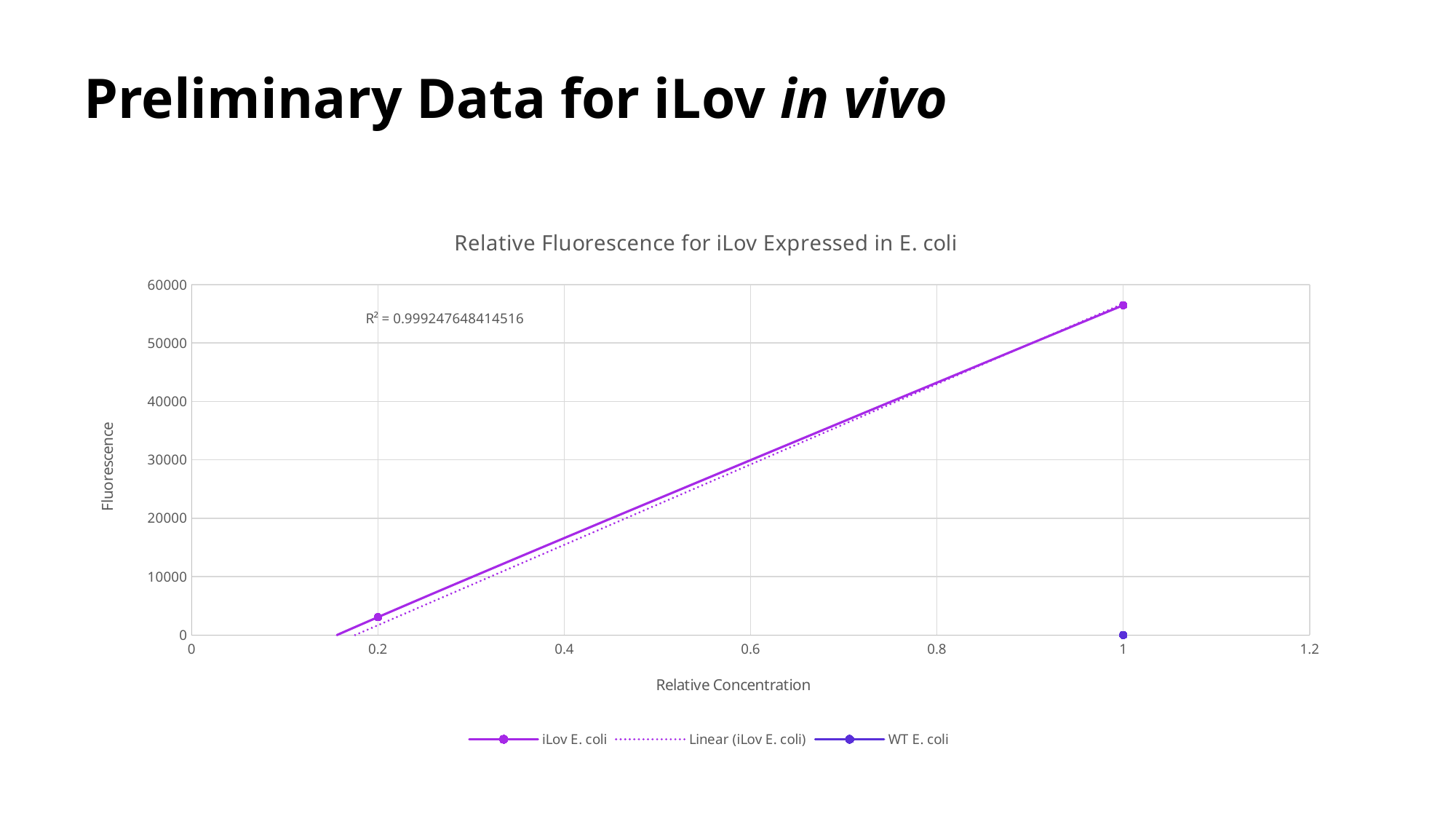
Which series is drawn as a dotted line in the legend? Linear (iLov E. coli) Is the fluorescence value for WT E. coli at a relative concentration of 1 greater or less than 10000? less How many entries does the chart legend list? 3 Is the fluorescence value for iLov E. coli at a relative concentration of 0.2 greater or less than 10000? less Is the fluorescence value for iLov E. coli at a relative concentration of 1 greater or less than 50000? greater What kind of chart is shown on the slide? line chart What is the R² value printed on the chart? R² = 0.999247648414516 At a relative concentration of 1, which series has the higher fluorescence, iLov E. coli or WT E. coli? iLov E. coli Does the fluorescence for iLov E. coli rise or fall as relative concentration increases? rise What is the title of the chart? Relative Fluorescence for iLov Expressed in E. coli What is the label of the y axis? Fluorescence